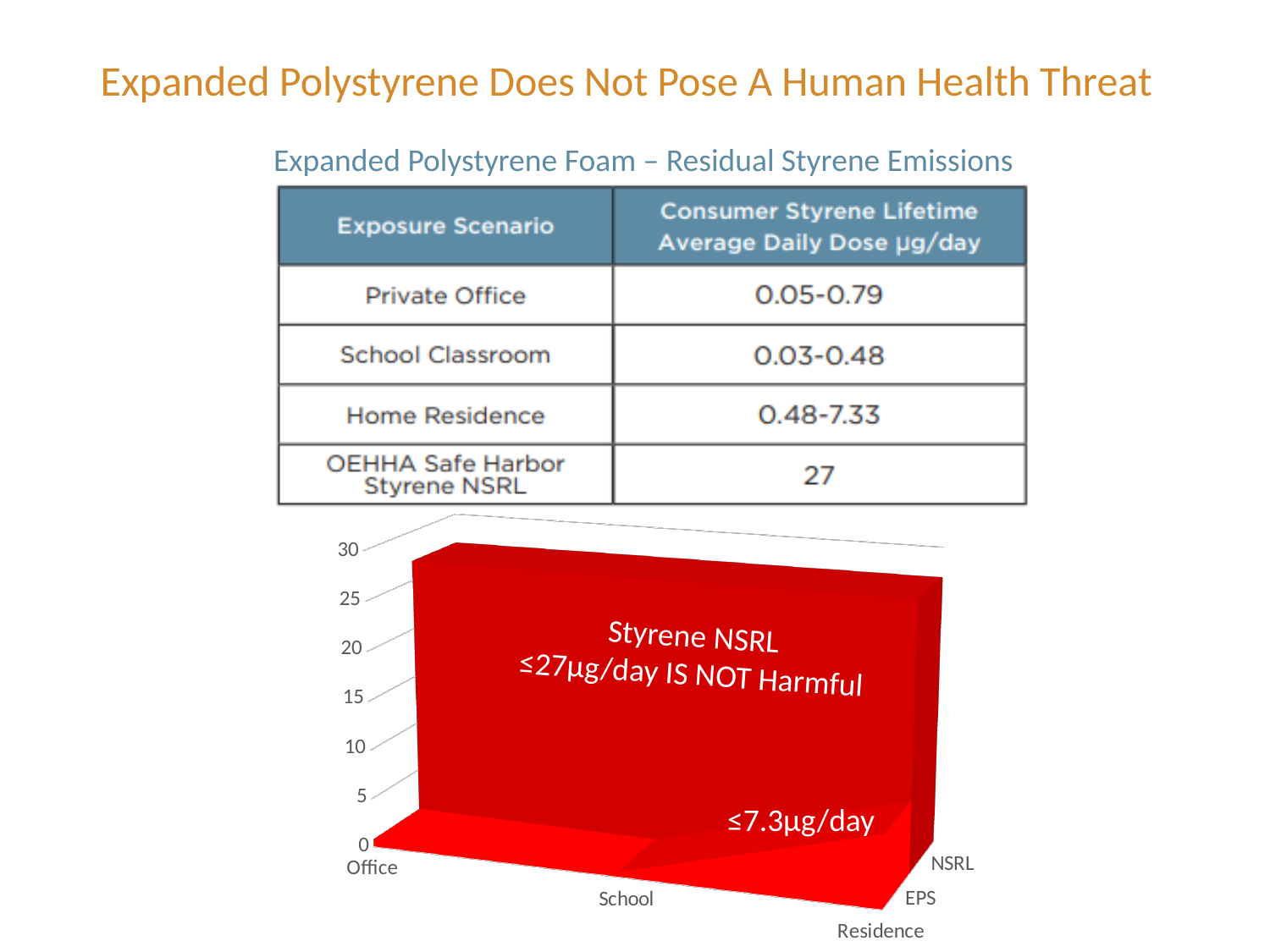
Which categories are labelled along the front axis of the chart? Office, School, Residence What is the highest value shown on the chart's vertical axis? 30 How many series are labelled on the depth axis of the chart? 2 Is the value of the NSRL series in the chart greater or less than 20? greater What value does the label on the EPS series near Residence give? ≤7.3µg/day What value does the label on the NSRL series give as not harmful? ≤27µg/day What kind of chart is shown at the bottom of the slide? 3D area chart What are the two series labelled on the depth axis of the chart? EPS and NSRL Is the value of the EPS series for Office greater or less than 10? less How many categories are labelled along the front axis of the chart? 3 Which series in the chart has the larger values, EPS or NSRL? NSRL Is the value of the NSRL series in the chart greater or less than 30? less